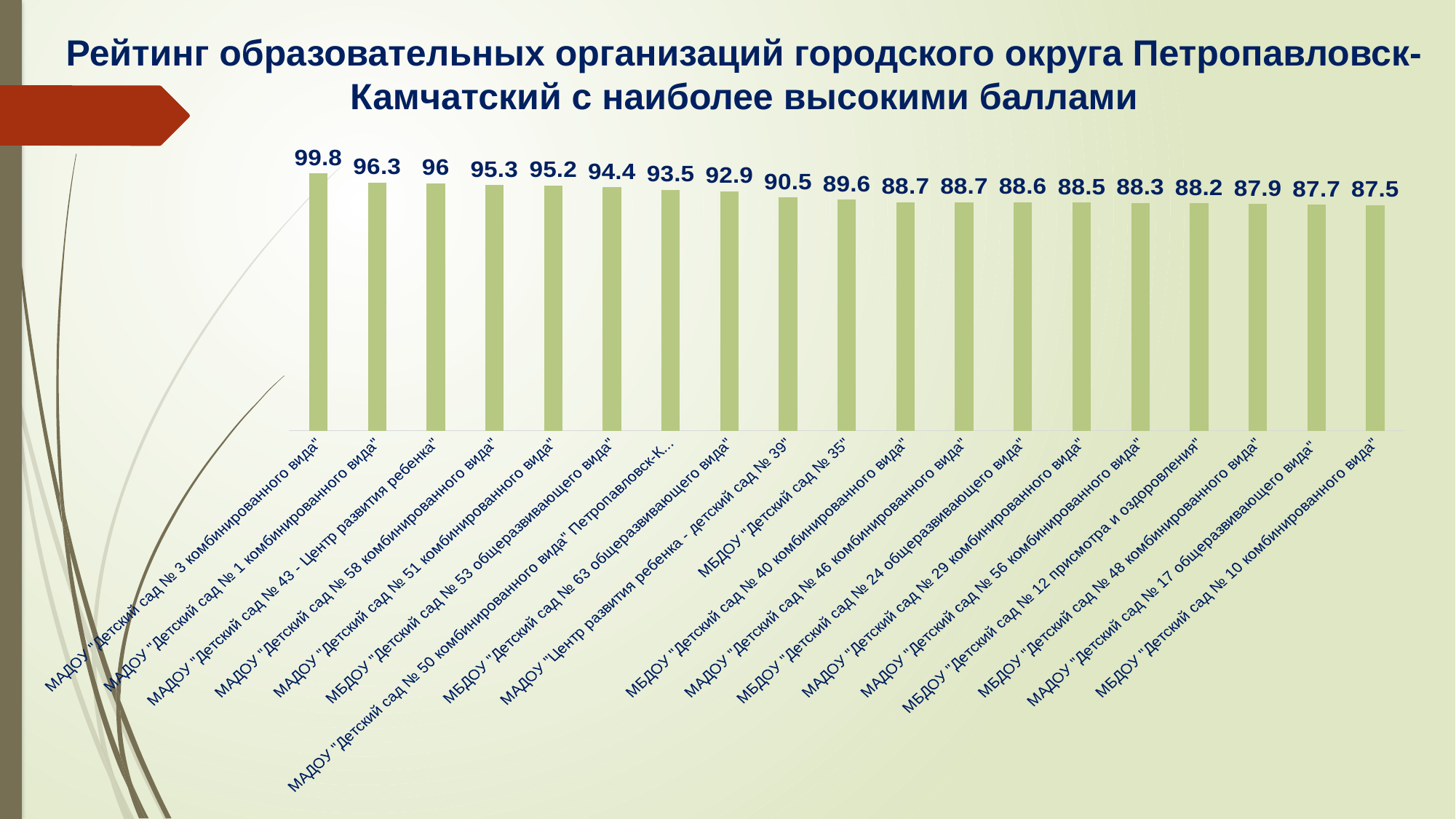
Which organisation has the highest score in the chart? МАДОУ "Детский сад № 3 комбинированного вида" Do the scores rise or fall from left to right across the chart? fall What type of chart is shown on the slide? bar chart How many organisations (bars) are shown in the chart? 19 Which organisation has the lowest score in the chart? МБДОУ "Детский сад № 10 комбинированного вида" What is the score for МАДОУ "Детский сад № 3 комбинированного вида"? 99.8 What is the score for МБДОУ "Детский сад № 12 присмотра и оздоровления"? 88.2 What is the difference between the highest score (99.8) and the lowest score (87.5)? 12.3 What is the score for МАДОУ "Детский сад № 43 - Центр развития ребенка"? 96 What is the score for МБДОУ "Детский сад № 35"? 89.6 Which has a higher score: МАДОУ "Детский сад № 58 комбинированного вида" or МБДОУ "Детский сад № 53 общеразвивающего вида"? МАДОУ "Детский сад № 58 комбинированного вида" What is the difference between the scores of МАДОУ "Детский сад № 1 комбинированного вида" and МБДОУ "Детский сад № 63 общеразвивающего вида"? 3.4